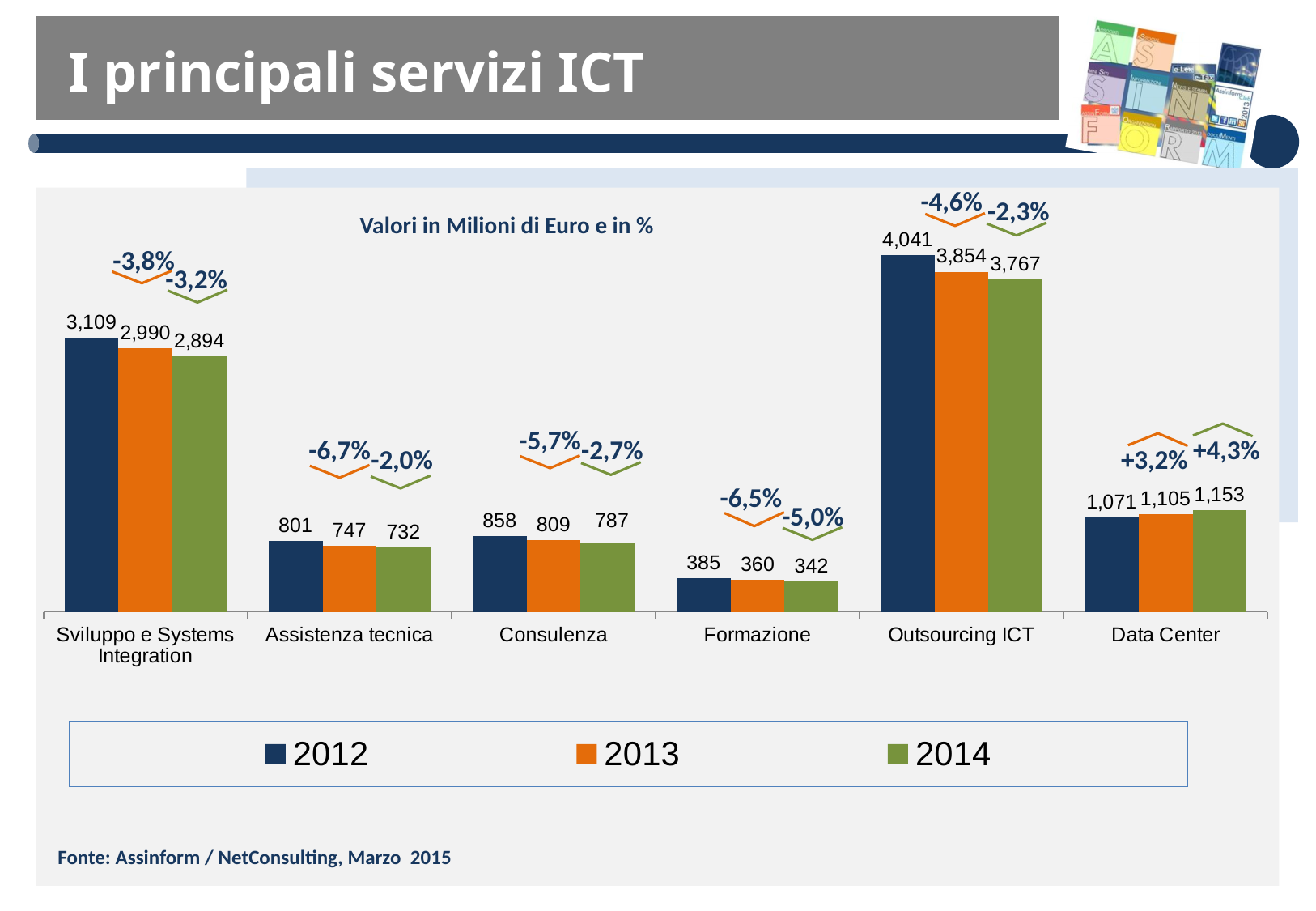
What is the difference between the 2012 and 2014 values for Sviluppo e Systems Integration? 215 How many categories are shown on the x axis? 6 What is the value for Formazione in 2012? 385 Do the values for Data Center rise or fall from 2012 to 2014? Rise Which category has the highest value in 2012? Outsourcing ICT How many series does the legend list? 3 What kind of chart is shown on the slide? Bar chart What is the value for Data Center in 2013? 1,105 Which is larger: the 2013 value for Assistenza tecnica or the 2013 value for Consulenza? Consulenza What percentage change is shown above the 2014 bar for Outsourcing ICT? -2,3% Which category has the lowest value in 2014? Formazione What is the value for Outsourcing ICT in 2014? 3,767